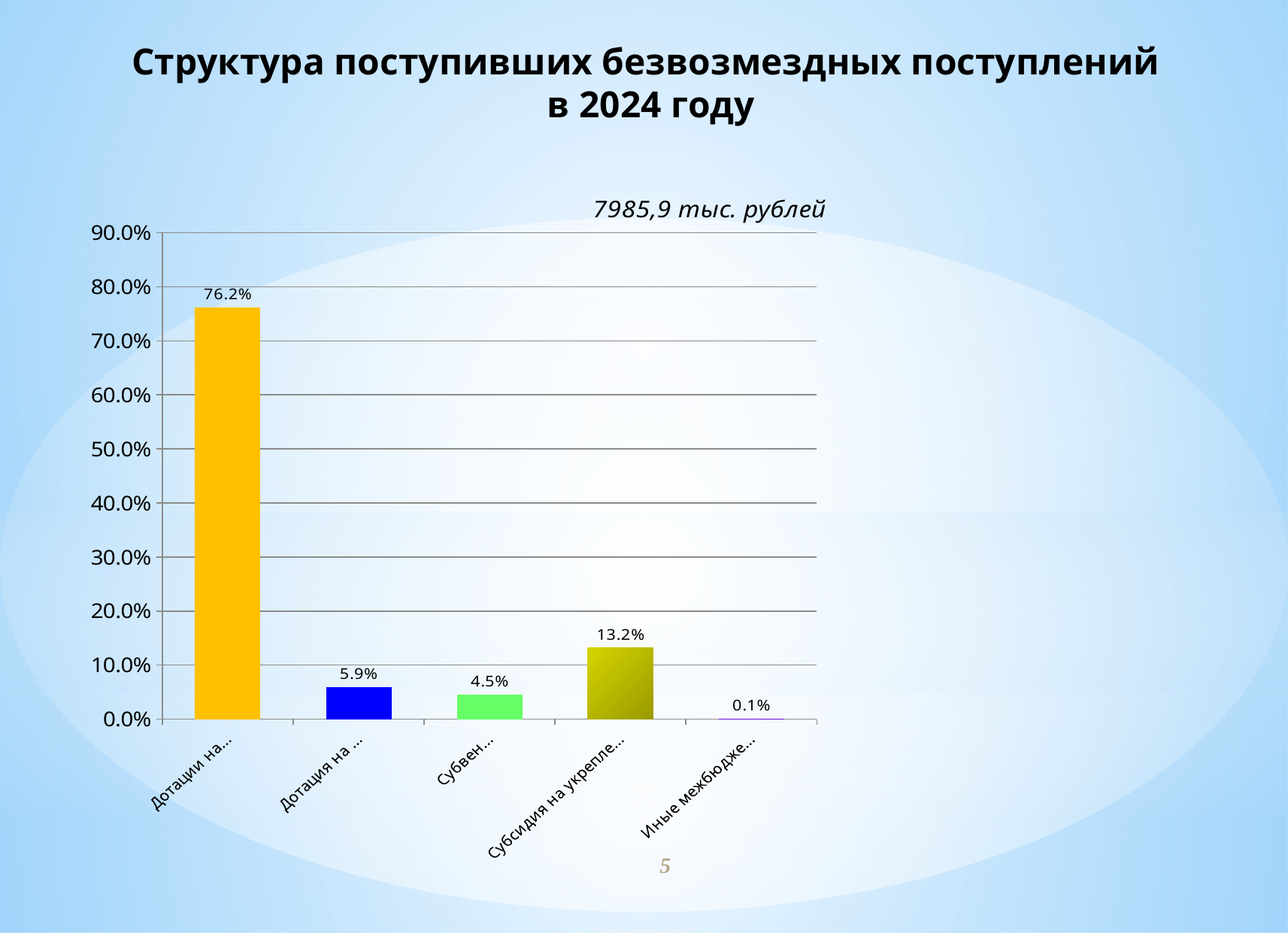
What is the value of the first (yellow) bar in the chart? 76.2% How many bars are plotted in the chart? 5 What total amount in thousand rubles is noted above the chart? 7985,9 тыс. рублей Which bar has the highest value in the chart? The first (yellow) bar, 76.2% Which bar has the lowest value in the chart? The last bar (Иные межбюдже...), 0.1% What is the value of the green bar labelled "Субвен..."? 4.5% What is the value of the fourth bar, labelled "Субсидия на укрепле..."? 13.2% Which is larger: the second bar (blue) or the third bar (green)? The second bar (blue), 5.9% What is the value of the second (blue) bar in the chart? 5.9% What is the difference between the first bar (76.2%) and the fourth bar (13.2%)? 63.0% What kind of chart is shown on the slide? Bar chart What is the value of the last bar, labelled "Иные межбюдже..."? 0.1%